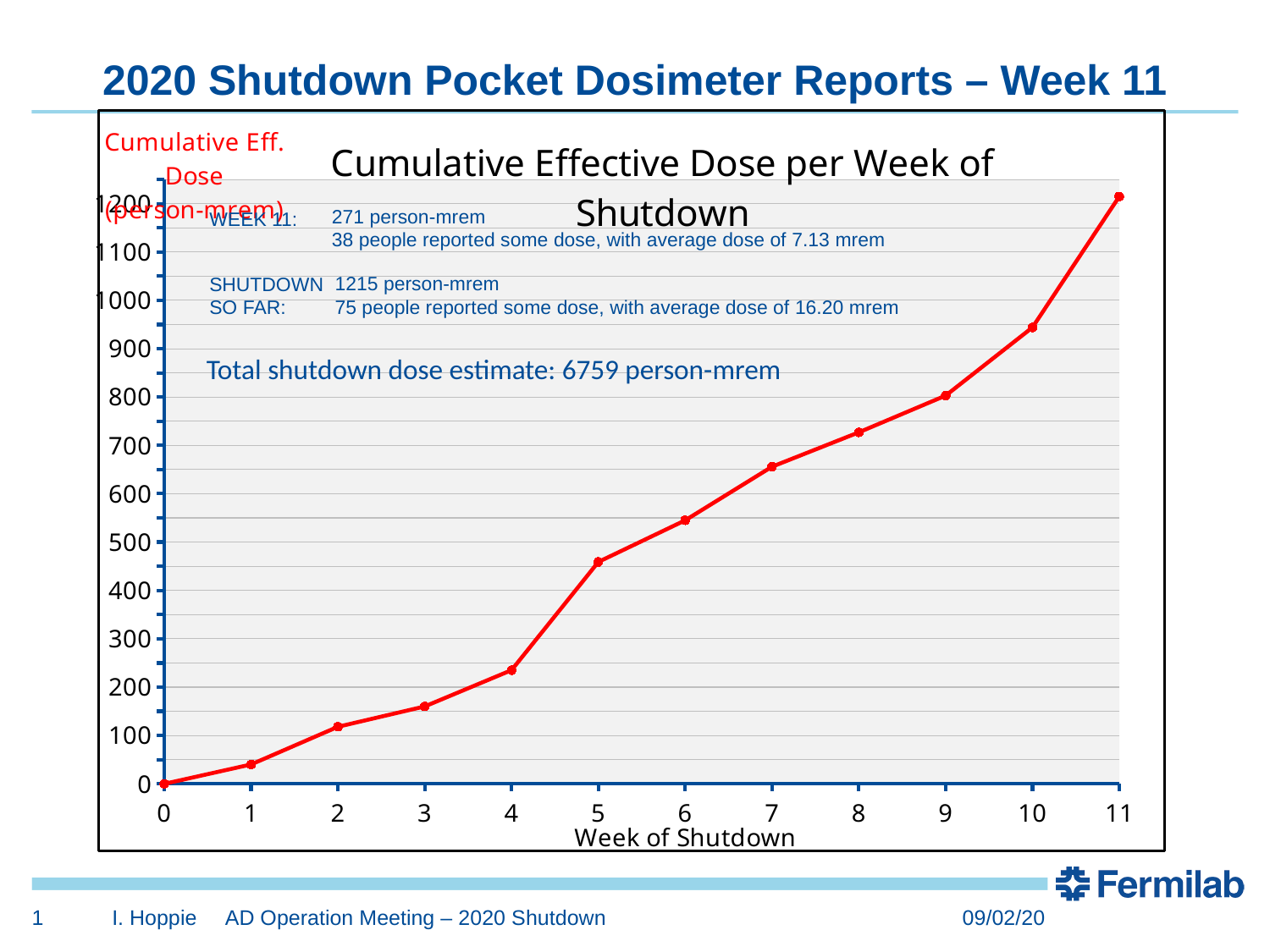
Is the value for week 5 greater or less than 400? greater Is the value for week 3 greater or less than 200? less What kind of chart is shown on the slide? line chart Is the value for week 10 greater or less than 1000? less At which week of shutdown is the cumulative effective dose highest? 11 What is the label of the x axis? Week of Shutdown What is the cumulative effective dose at week 0? 0 How many data points are plotted on the line? 12 Which is larger, the value for week 7 or the value for week 6? week 7 At which week of shutdown is the cumulative effective dose lowest? 0 Do the values rise or fall as the week of shutdown increases? rise What is the title of the chart? Cumulative Effective Dose per Week of Shutdown